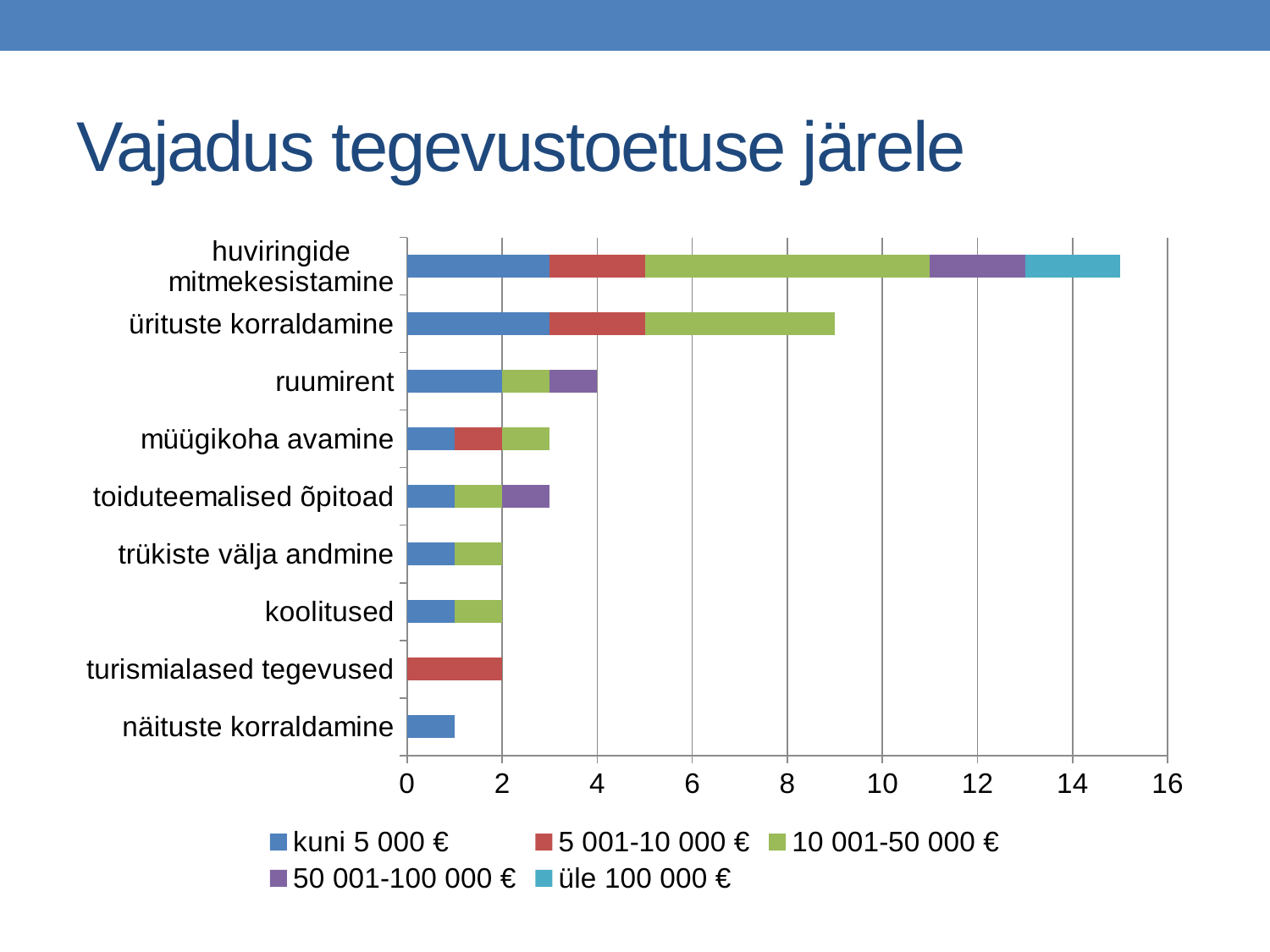
What kind of chart is shown on the slide? bar chart How many categories are shown on the chart? 9 Is the total for näituste korraldamine greater or less than 2? less Which has a larger total, ürituste korraldamine or ruumirent? ürituste korraldamine How many series does the legend list? 5 Is the total for huviringide mitmekesistamine greater or less than 14? greater Is the total for ürituste korraldamine greater or less than 8? greater Which category has the longest total bar? huviringide mitmekesistamine Which category has the shortest total bar? näituste korraldamine What is the total of the stacked bar for ruumirent? 4 What is the total of the stacked bar for koolitused? 2 What is the title of the slide? Vajadus tegevustoetuse järele